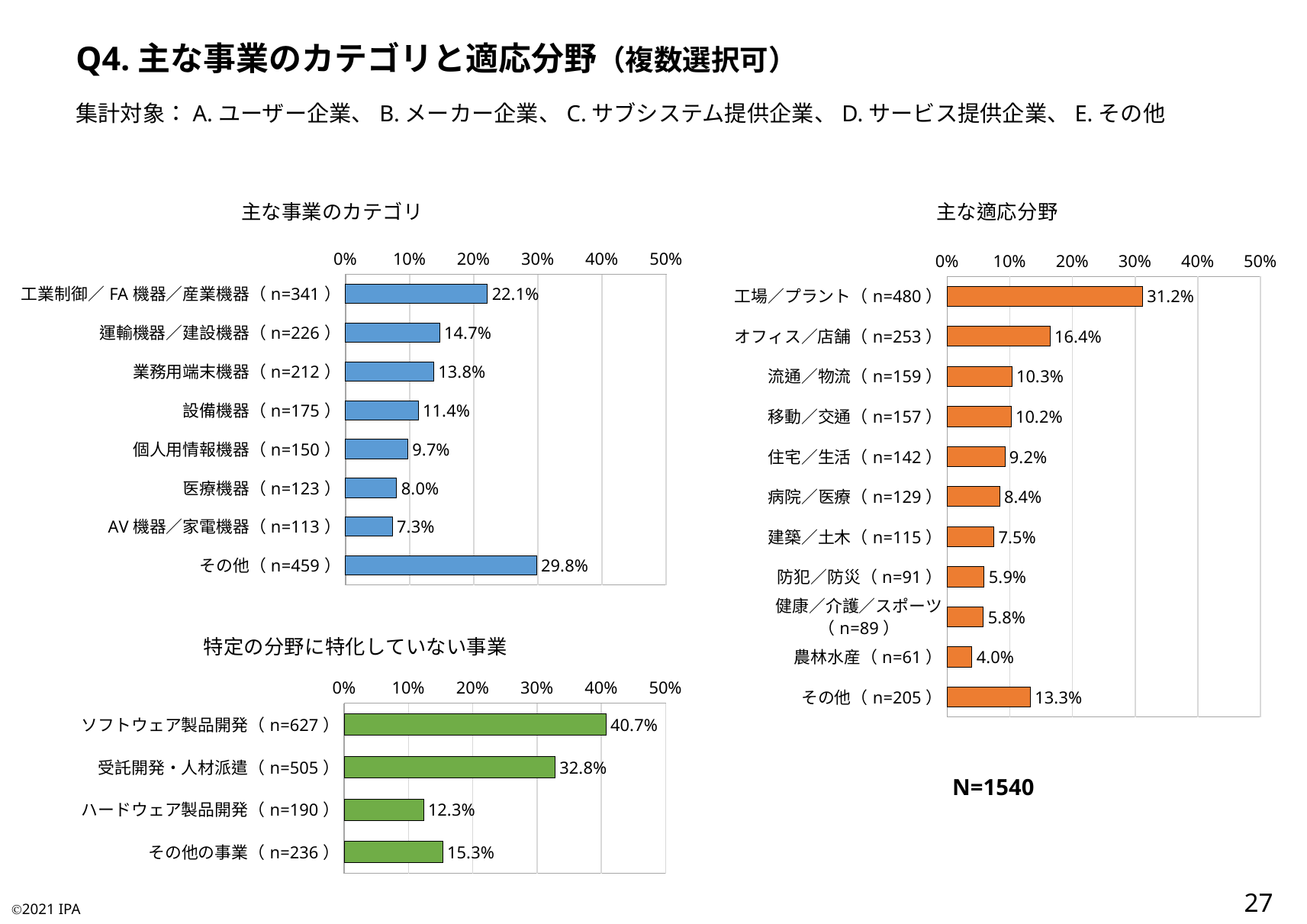
In the 主な適応分野 chart, what is the difference between 工場／プラント and オフィス／店舗? 14.8% In the 特定の分野に特化していない事業 chart, is the value for ソフトウェア製品開発 greater or less than 40%? greater In the 主な事業のカテゴリ chart, which category has the lowest value? AV機器／家電機器 In the 主な適応分野 chart, what is the value for 工場／プラント? 31.2% What kind of chart is the 主な適応分野 chart? bar chart In the 主な適応分野 chart, which category has the lowest value? 農林水産 In the 主な事業のカテゴリ chart, how many categories are plotted? 8 In the 主な事業のカテゴリ chart, what is the value for 工業制御／FA機器／産業機器? 22.1% In the 主な事業のカテゴリ chart, which category has the highest value? その他 In the 主な適応分野 chart, how many categories are plotted? 11 In the 特定の分野に特化していない事業 chart, which is larger, ハードウェア製品開発 or その他の事業? その他の事業 In the 特定の分野に特化していない事業 chart, what is the value for 受託開発・人材派遣? 32.8%